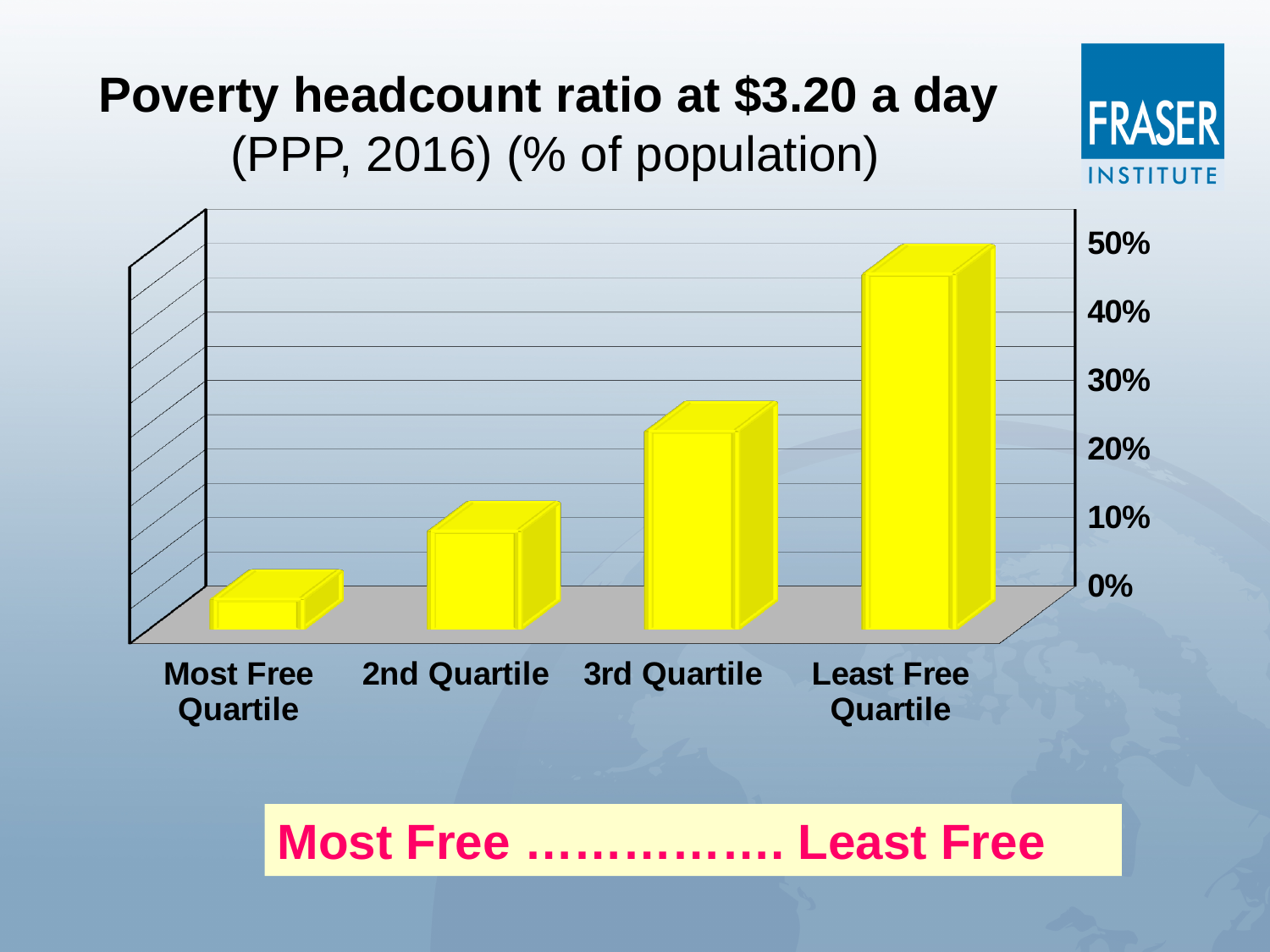
Is the value for the Least Free Quartile greater or less than 40%? greater What kind of chart is shown on the slide? bar chart Do the values rise or fall moving from the Most Free Quartile to the Least Free Quartile? rise What is the title of the chart? Poverty headcount ratio at $3.20 a day (PPP, 2016) (% of population) Which has a higher poverty headcount ratio, the 2nd Quartile or the 3rd Quartile? 3rd Quartile Is the value for the 3rd Quartile greater or less than 30%? less Which quartile has the highest poverty headcount ratio? Least Free Quartile Is the value for the 3rd Quartile greater or less than 20%? greater Which quartile has the lowest poverty headcount ratio? Most Free Quartile How many categories are plotted on the chart? 4